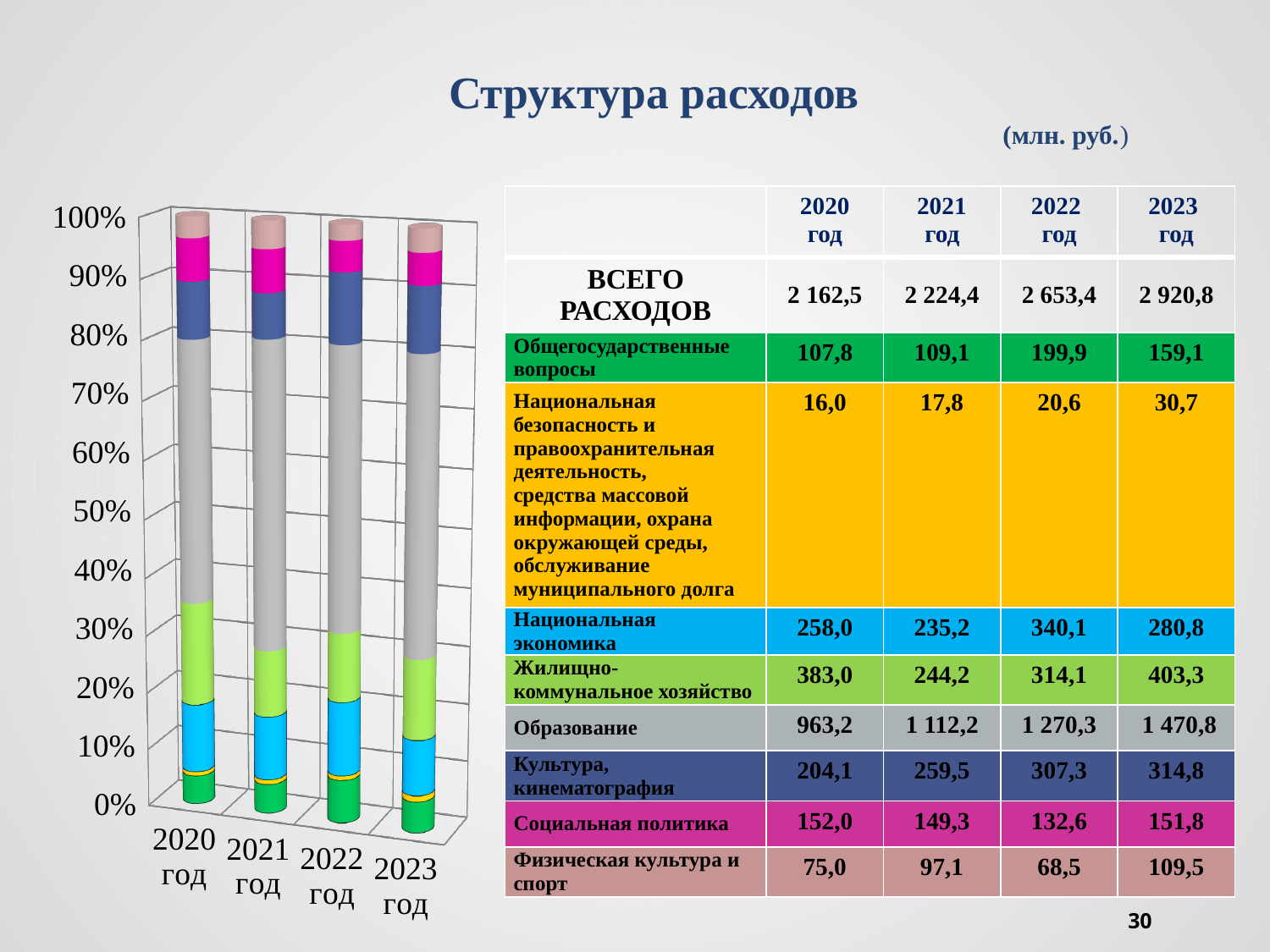
What is the highest value shown on the chart's vertical axis? 100% Which colour in the chart represents Образование? grey Which is larger for Национальная экономика: 2022 год or 2023 год? 2022 год What kind of chart is shown on the left of the slide? stacked bar chart Do the values for Образование rise or fall from 2020 год to 2023 год? rise Which year has the lowest value for Физическая культура и спорт? 2022 год What is the value of ВСЕГО РАСХОДОВ for 2020 год? 2 162,5 Which year has the highest ВСЕГО РАСХОДОВ? 2023 год How many years (categories) are plotted on the x axis of the chart? 4 In the 2020 год bar, is the top of the grey (Образование) segment greater or less than 70%? greater What is the difference between Общегосударственные вопросы in 2022 год and 2021 год? 90,8 What is the value for Образование in 2023 год? 1 470,8